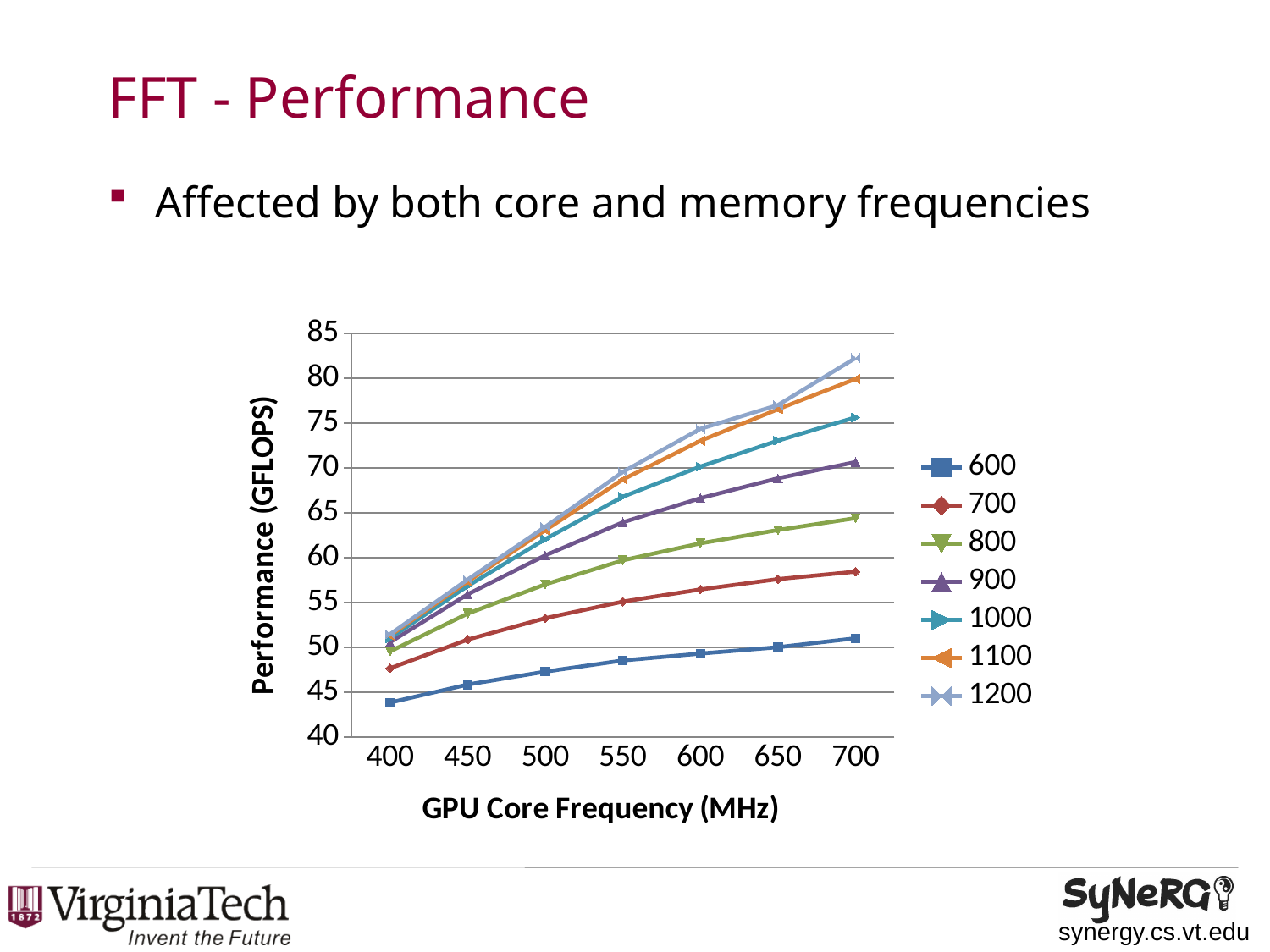
What kind of chart is shown on the slide? line chart Is the value for the 1200 series at 700 MHz greater or less than 80? greater How many series does the legend list? 7 Is the value for the 800 series at 400 MHz greater or less than 55? less How many GPU core frequency points are plotted along the x axis? 7 Does the performance of the 600 series rise or fall as GPU core frequency increases from 400 to 700 MHz? rise Is the value for the 600 series at 400 MHz greater or less than 45? less At 700 MHz, which series has the higher performance, 1200 or 600? 1200 Which series has the highest performance at 700 MHz? 1200 Which series has the lowest performance at 400 MHz? 600 What is the title of the x axis? GPU Core Frequency (MHz)